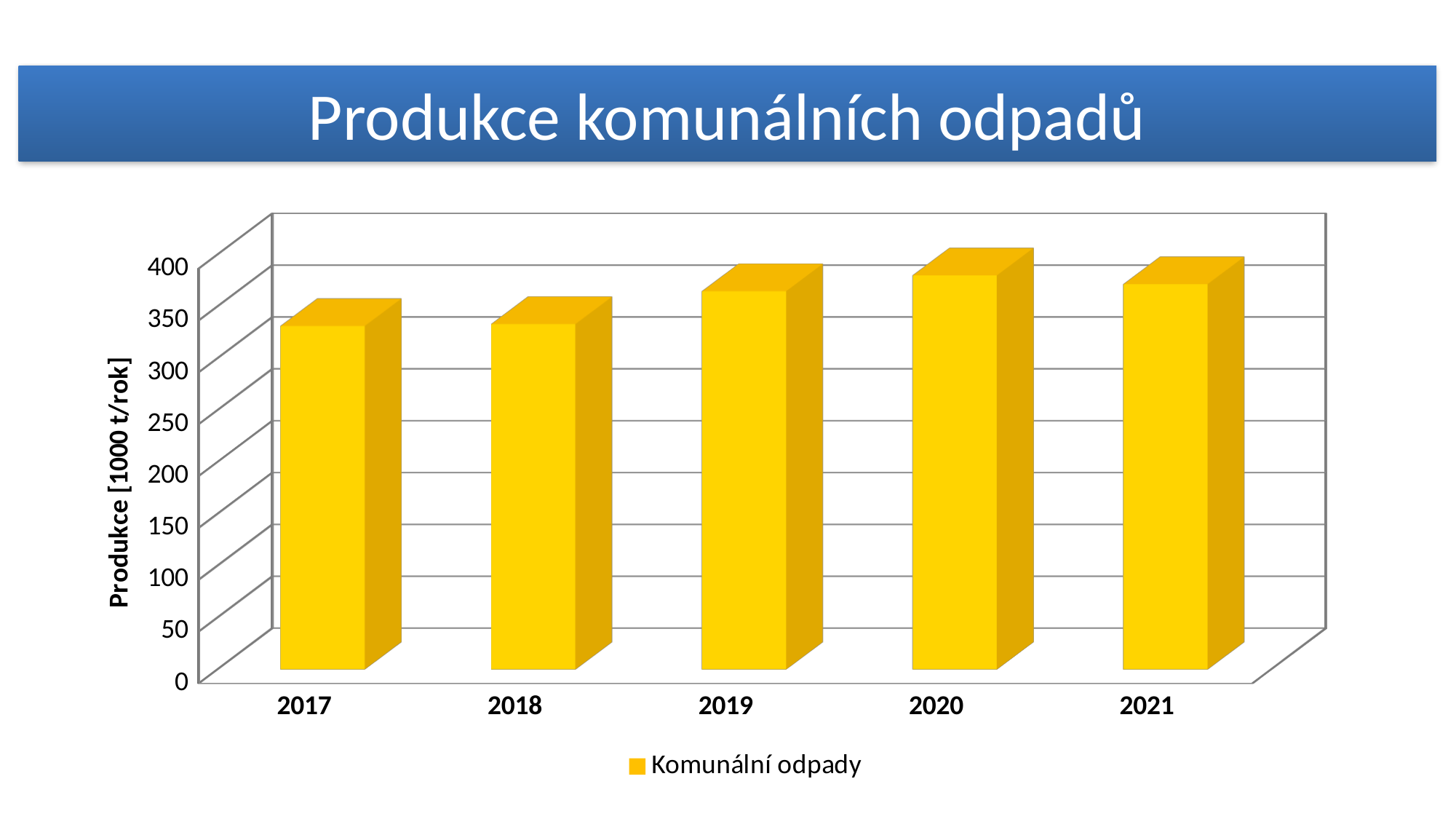
Which year has the highest value in the chart? 2020 Is the value for 2020 greater or less than 350? greater Is the value for 2018 greater or less than 400? less How many years are shown on the x axis of the chart? 5 What is the label of the y axis? Produkce [1000 t/rok] What is the title of the slide? Produkce komunálních odpadů Which is larger, the value for 2019 or the value for 2018? 2019 How many series does the legend list? 1 What kind of chart is shown on the slide? bar chart Is the value for 2021 greater or less than 400? less Which is larger, the value for 2020 or the value for 2017? 2020